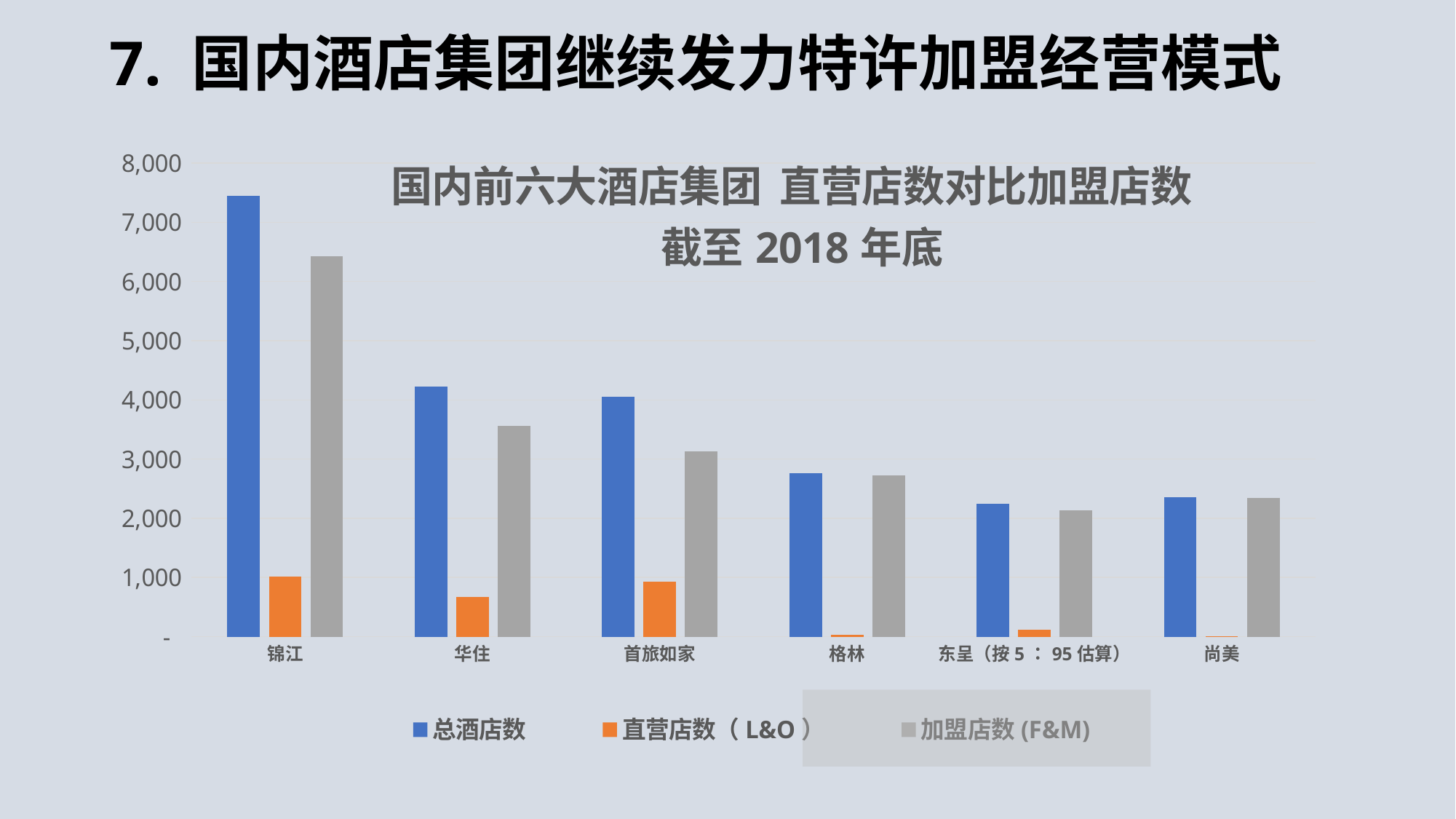
How many hotel groups are shown on the x axis of the chart? 6 What kind of chart is shown on the slide? bar chart Is the 加盟店数 (F&M) value for 格林 greater or less than 2,000? greater Which is larger, the 直营店数（L&O）for 首旅如家 or for 华住? 首旅如家 How many series does the chart legend list? 3 Which hotel group has the highest 加盟店数 (F&M)? 锦江 Which is larger, the 加盟店数 (F&M) for 锦江 or for 华住? 锦江 Is the 直营店数（L&O）value for 锦江 greater or less than 2,000? less Is the 加盟店数 (F&M) value for 华住 greater or less than 3,000? greater Which hotel group has the highest 总酒店数? 锦江 What colour are the 加盟店数 (F&M) bars in the chart? grey